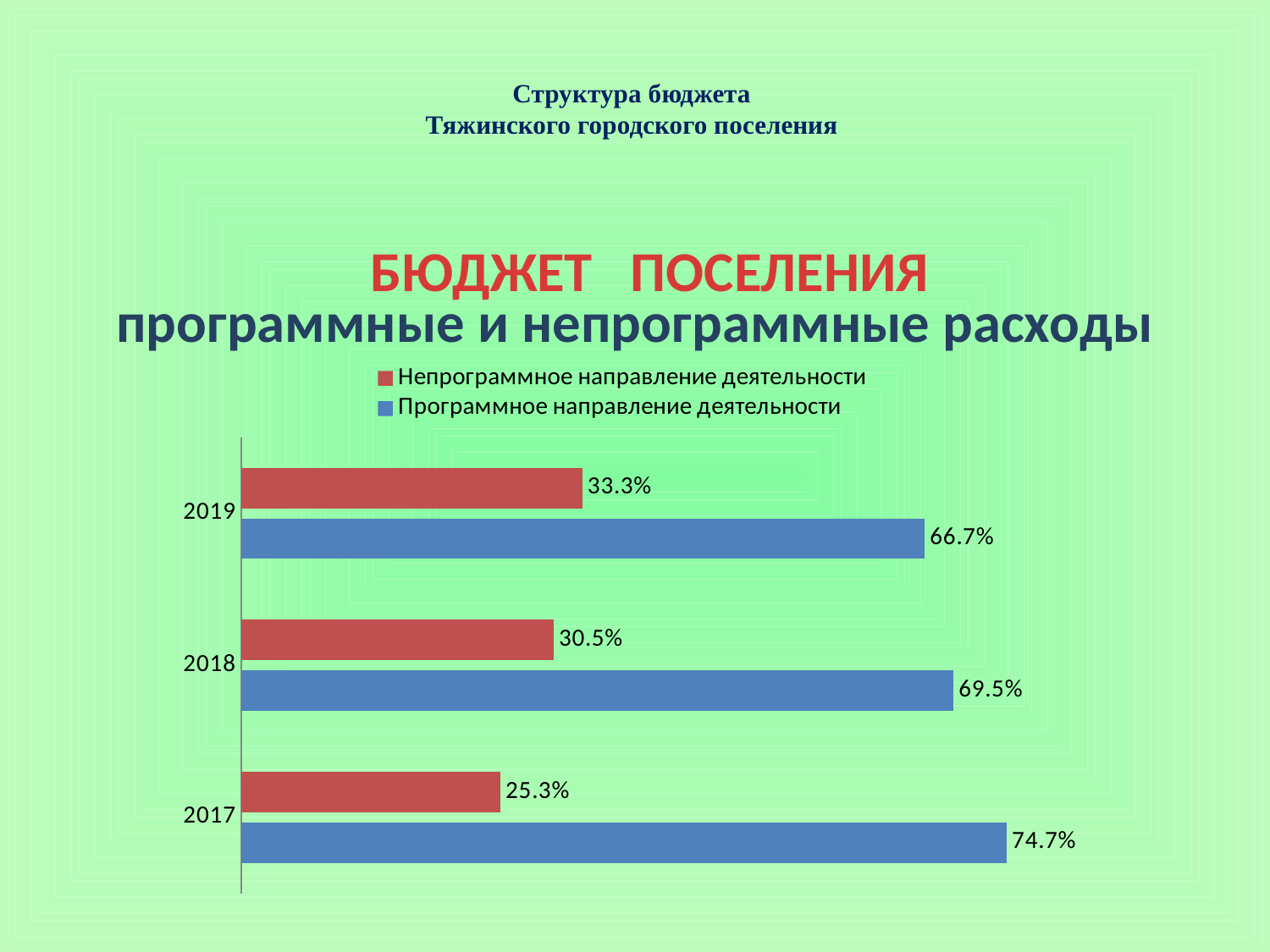
What is the difference between the Программное and Непрограммное values in 2019? 33.4% In which year is the value for Программное направление деятельности the highest? 2017 How many years are shown on the chart? 3 What is the value for Непрограммное направление деятельности in 2018? 30.5% What is the value for Программное направление деятельности in 2017? 74.7% What is the value for Непрограммное направление деятельности in 2019? 33.3% What colour represents Программное направление деятельности in the chart? Blue Which is larger in 2018: Программное направление деятельности or Непрограммное направление деятельности? Программное направление деятельности What kind of chart is shown on the slide? Bar chart In which year is the value for Непрограммное направление деятельности the lowest? 2017 How many series does the legend list? 2 Does the value for Непрограммное направление деятельности rise or fall from 2017 to 2019? Rise